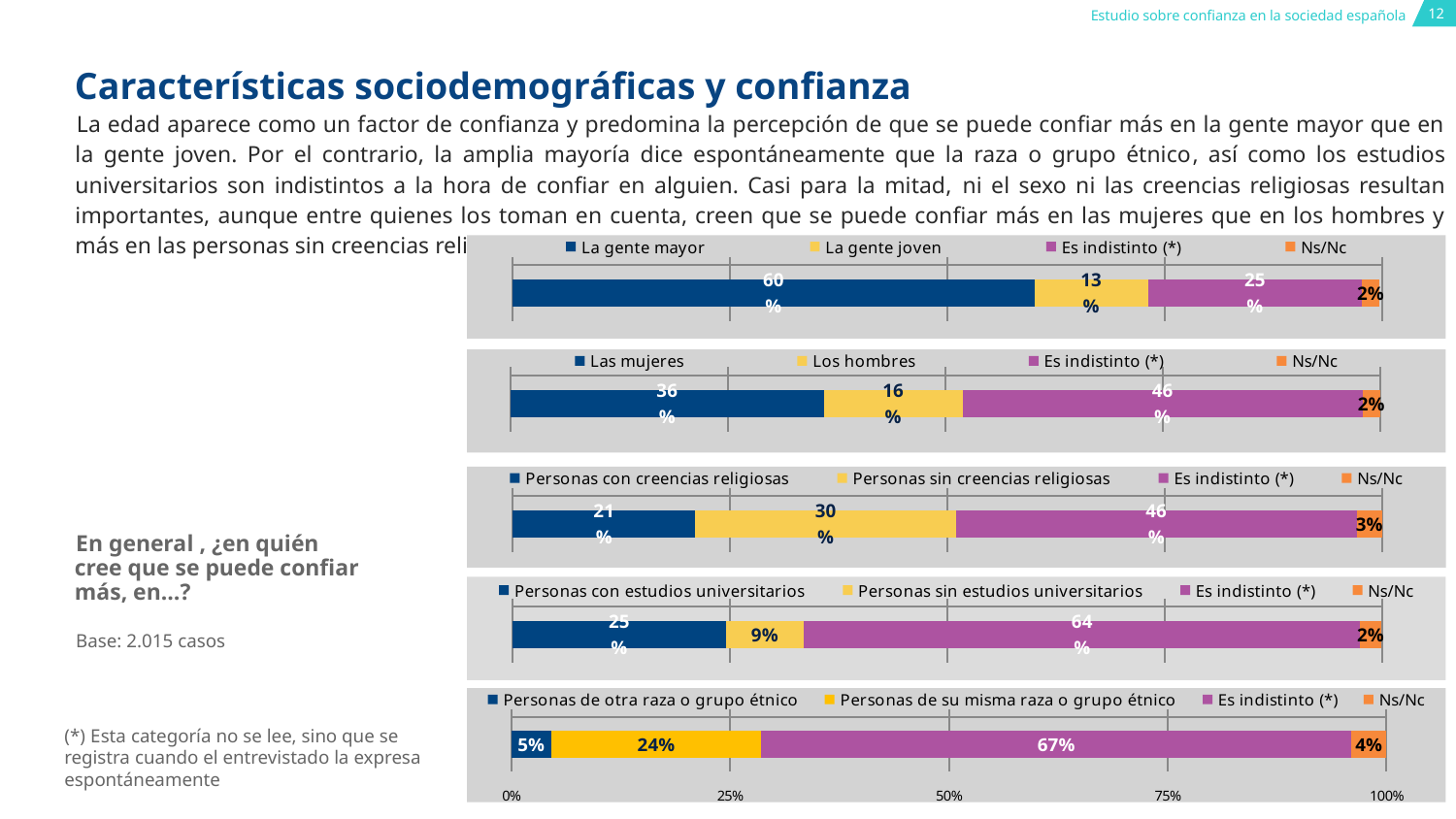
In the fourth chart from the top (estudios universitarios), what is the value for 'Es indistinto (*)'? 64% In the bottom chart (raza o grupo étnico), what is the value for 'Personas de su misma raza o grupo étnico'? 24% In the third chart from the top (creencias religiosas), what is the value for 'Ns/Nc'? 3% What type of chart is the top chart (La gente mayor / La gente joven)? Stacked bar chart In the fourth chart from the top (estudios universitarios), which is larger: 'Personas con estudios universitarios' or 'Personas sin estudios universitarios'? Personas con estudios universitarios In the top chart (La gente mayor / La gente joven), what is the value for 'La gente mayor'? 60% In the second chart from the top (Las mujeres / Los hombres), what is the value for 'Es indistinto (*)'? 46% In the bottom chart (raza o grupo étnico), which category has the lowest value? Ns/Nc In the second chart from the top (Las mujeres / Los hombres), what is the difference between 'Las mujeres' and 'Los hombres'? 20% In the top chart (La gente mayor / La gente joven), what is the value for 'La gente joven'? 13% How many series does the legend of the bottom chart (raza o grupo étnico) list? 4 In the third chart from the top (creencias religiosas), which category has the highest value? Es indistinto (*)